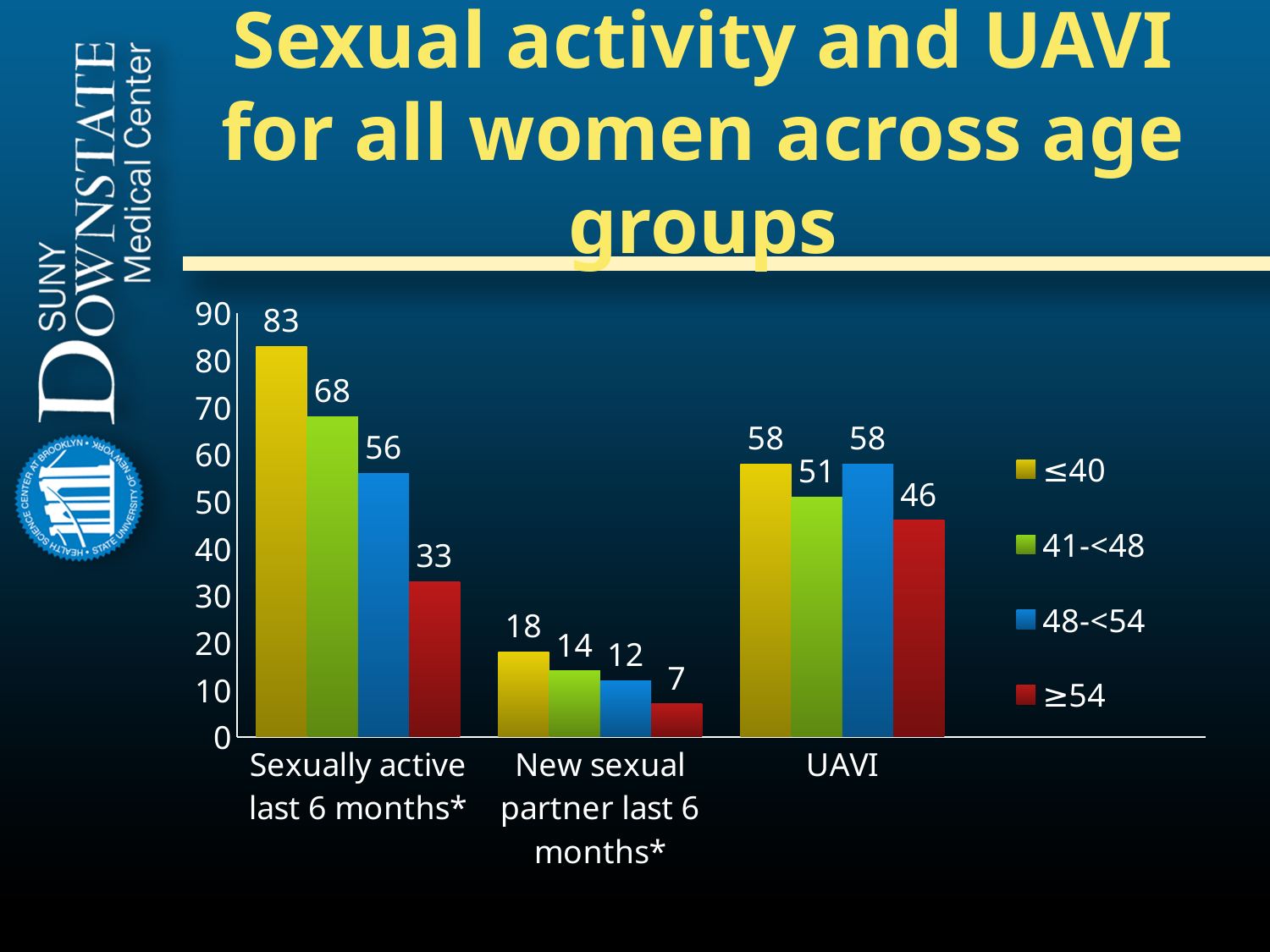
What is the difference between the 48-<54 and ≥54 values for UAVI? 12 Which age group has the lowest value for UAVI? ≥54 What is the value for the ≥54 age group for 'New sexual partner last 6 months*'? 7 How many series does the legend list? 4 Which colour represents the 48-<54 age group in the legend? Blue Which is larger for 'New sexual partner last 6 months*': the value for ≤40 or the value for 48-<54? ≤40 What kind of chart is shown on the slide? Bar chart What is the difference between the ≤40 and ≥54 values for 'Sexually active last 6 months*'? 50 How many categories are shown on the x axis? 3 Which age group has the highest value for 'Sexually active last 6 months*'? ≤40 What is the value for the 41-<48 age group for UAVI? 51 What is the value for the ≤40 age group for 'Sexually active last 6 months*'? 83